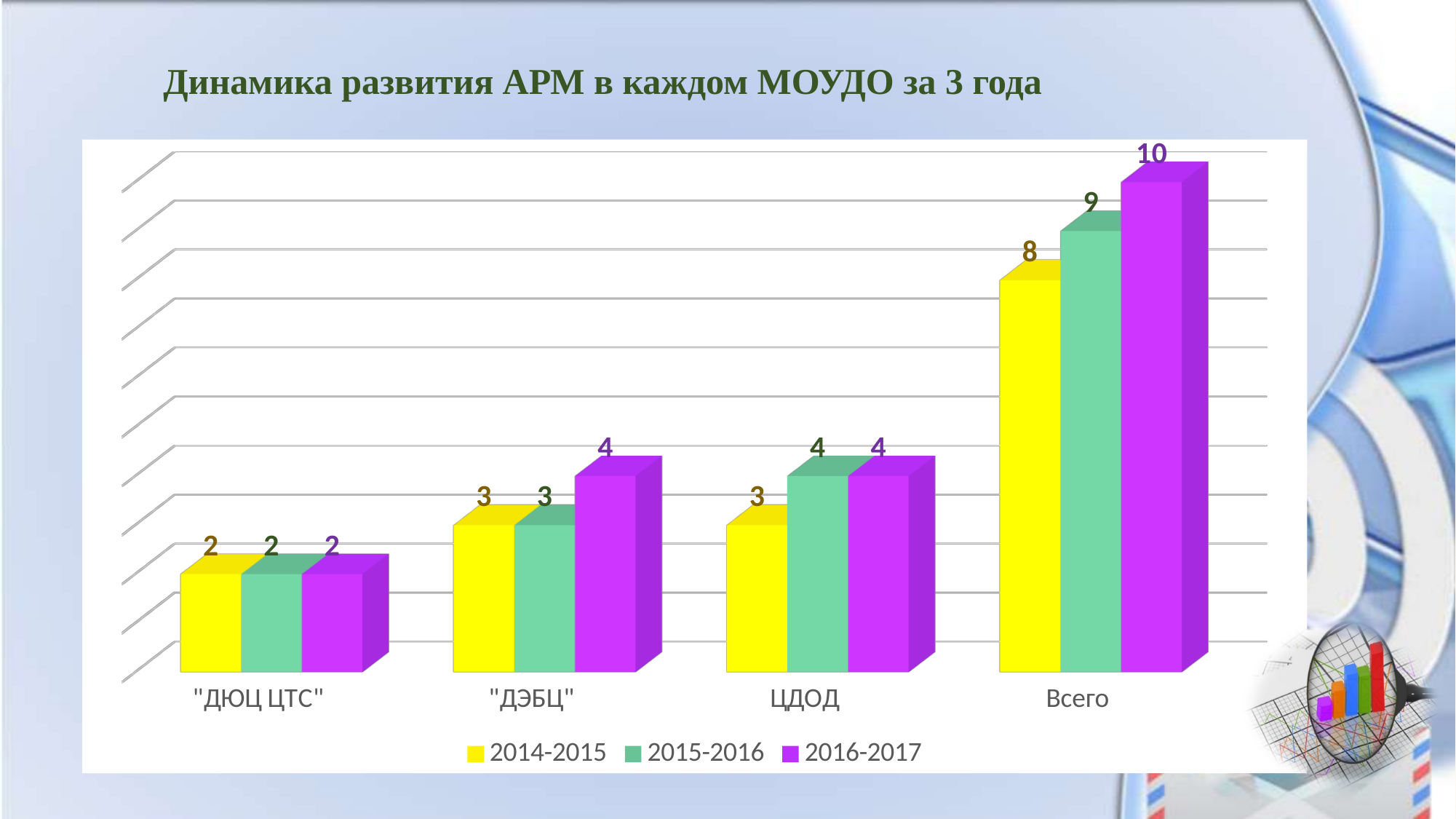
What is the value for "ДЭБЦ" in the 2016-2017 series? 4 What is the difference between the 2016-2017 and 2014-2015 values for Всего? 2 What is the value for Всего in the 2014-2015 series? 8 Do the values for Всего rise or fall from 2014-2015 to 2016-2017? Rise Which is larger for ЦДОД: the 2014-2015 value or the 2015-2016 value? 2015-2016 What is the value for ЦДОД in the 2015-2016 series? 4 Which category has the highest value in the 2016-2017 series? Всего How many categories are shown on the x axis? 4 What is the value for "ДЮЦ ЦТС" in the 2016-2017 series? 2 Which category has the lowest value in the 2015-2016 series? "ДЮЦ ЦТС" What kind of chart is shown on the slide? Bar chart How many series does the legend list? 3